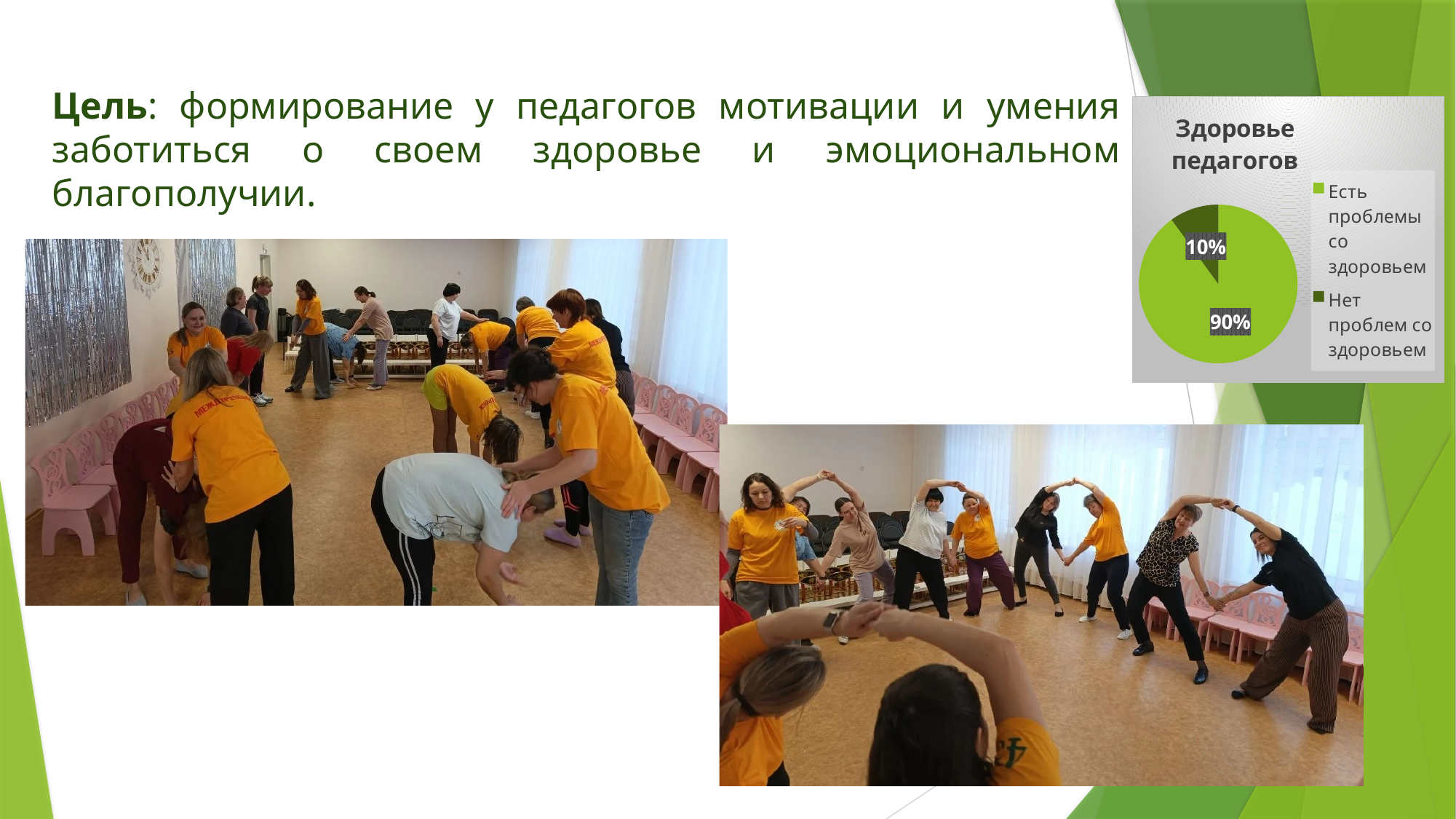
What is the difference in percentage points between the "Есть проблемы со здоровьем" and "Нет проблем со здоровьем" slices? 80% What kind of chart is shown on the slide? pie chart Which is larger: the share for "Есть проблемы со здоровьем" or for "Нет проблем со здоровьем"? Есть проблемы со здоровьем How many slices does the pie chart have? 2 What share of the pie is labelled "Есть проблемы со здоровьем"? 90% Which category has the smallest slice of the pie? Нет проблем со здоровьем Which legend entry is shown in the darker green colour? Нет проблем со здоровьем What is the title of the chart? Здоровье педагогов How many entries does the chart legend list? 2 What share of the pie is labelled "Нет проблем со здоровьем"? 10% Which category has the largest slice of the pie? Есть проблемы со здоровьем